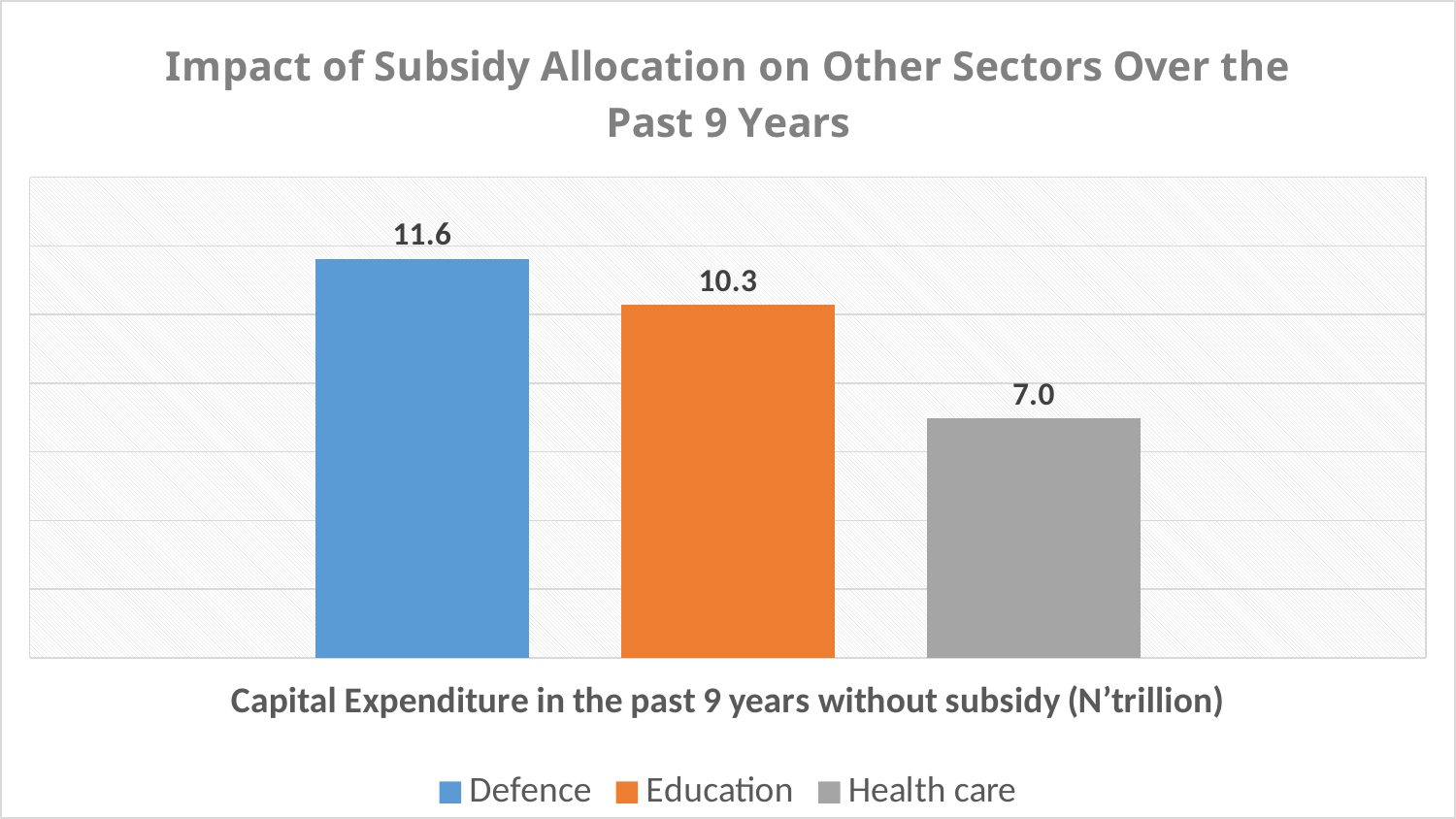
How many bars are plotted on the chart? 3 How many series does the legend list? 3 What is the difference between the values for Defence and Health care? 4.6 Which sector has the highest value? Defence What is the value for Defence? 11.6 What colour is the bar for Education? Orange What is the value for Health care? 7.0 What is the difference between the values for Defence and Education? 1.3 What is the value for Education? 10.3 What kind of chart is shown on the slide? Bar chart Which sector has the lowest value? Health care Which is larger, the value for Education or the value for Health care? Education